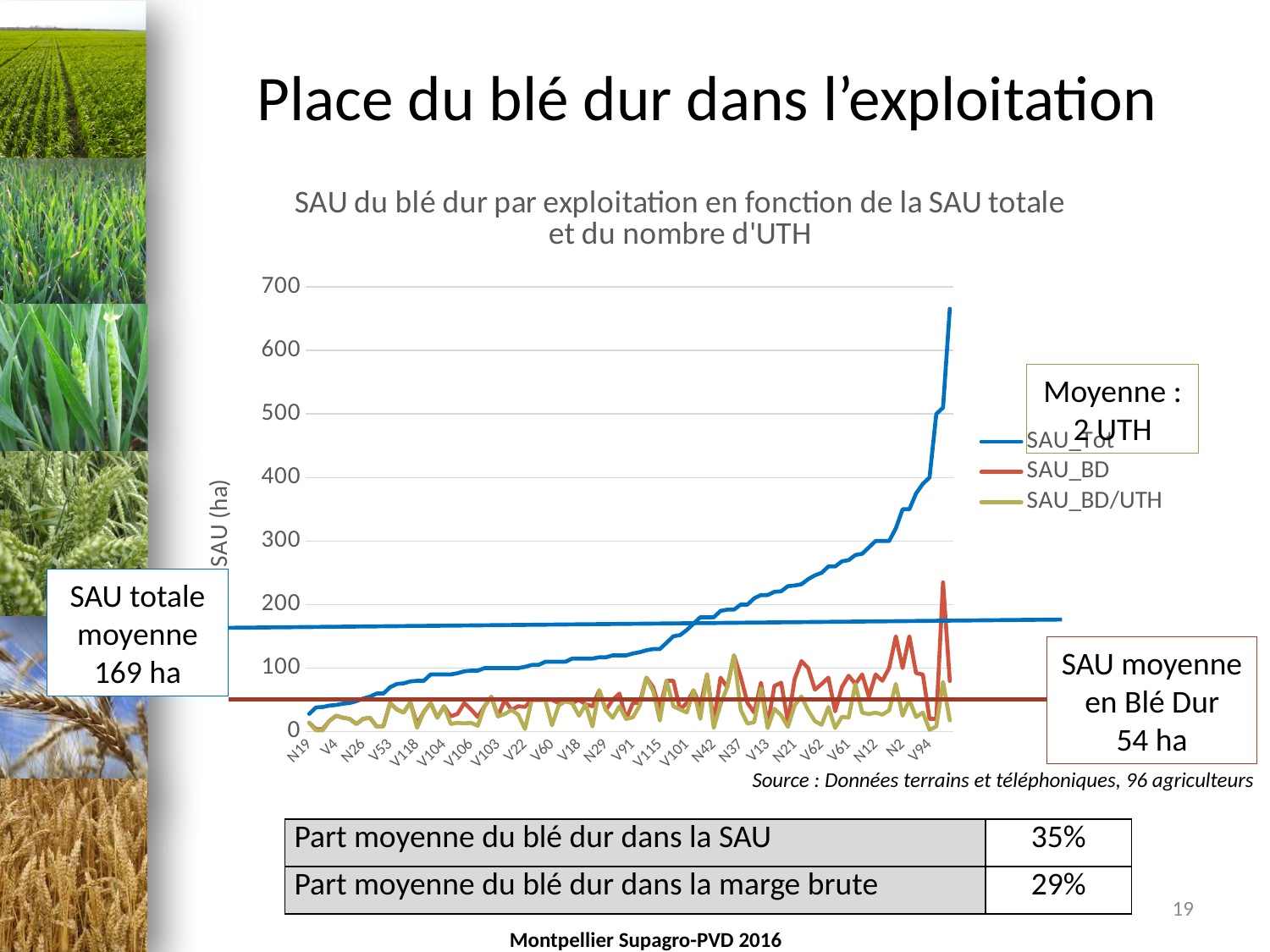
What are the three series named in the chart legend? SAU_Tot, SAU_BD, SAU_BD/UTH Is the value of SAU_Tot at the first category (N19) greater or less than 100? less Which series reaches the highest values on the chart? SAU_Tot What kind of chart is shown on the slide? line chart Is the highest value of the SAU_BD series greater or less than 300? less According to the annotation on the chart, what is the average total SAU (SAU totale moyenne)? 169 ha How many series does the chart legend list? 3 At the rightmost point of the chart, which series has the larger value, SAU_Tot or SAU_BD? SAU_Tot According to the annotation on the chart, what is the average SAU in durum wheat (SAU moyenne en Blé Dur)? 54 ha What is the label of the vertical axis of the chart? SAU (ha) Is the highest value of the SAU_Tot series greater or less than 600? greater Does the SAU_Tot series rise or fall from left to right along the x axis? rise